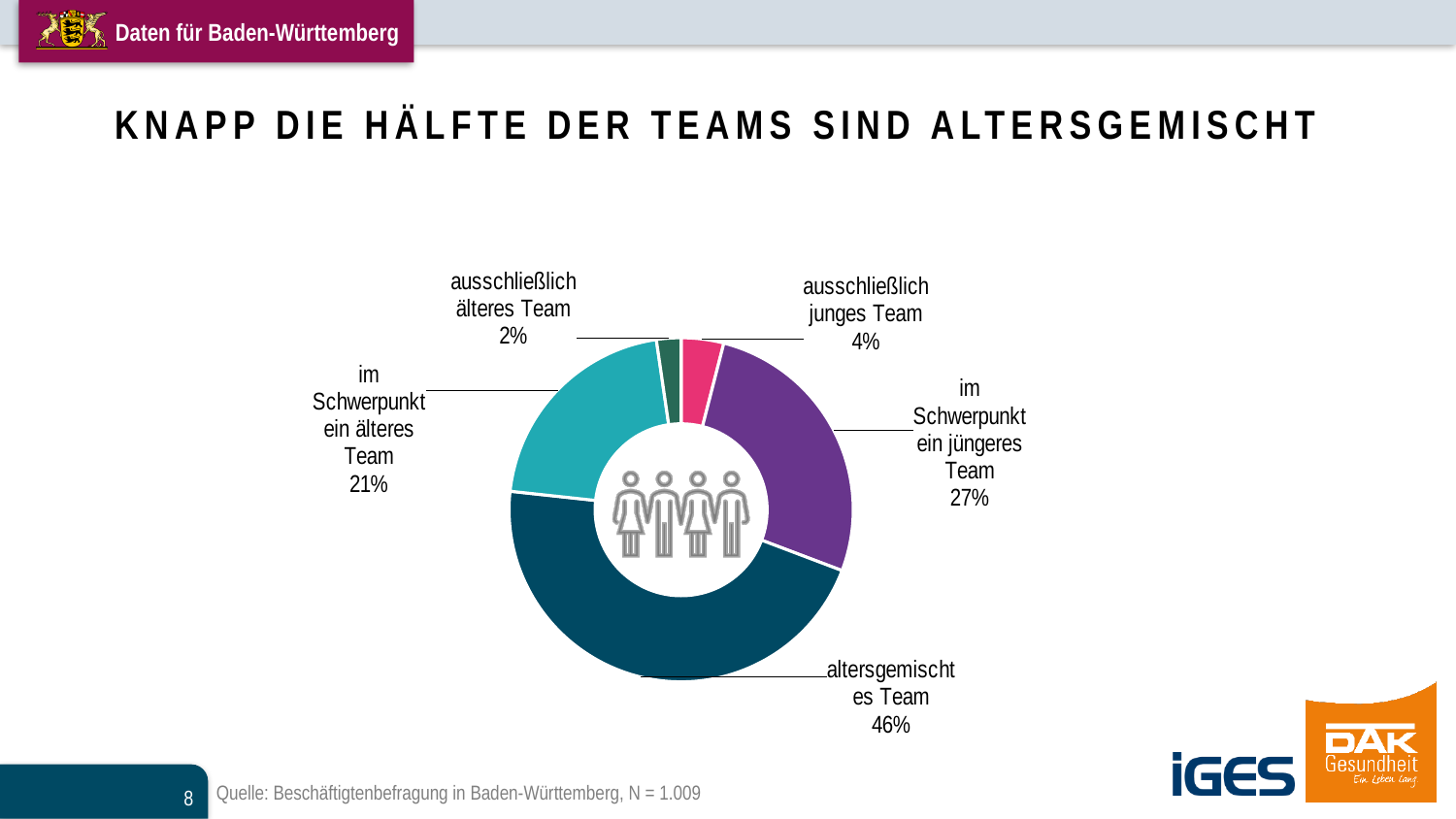
What kind of chart is shown on the slide? Pie chart (doughnut) How many categories are shown in the chart? 5 Which category has the smallest share of the chart? ausschließlich älteres Team What is the title of the slide? KNAPP DIE HÄLFTE DER TEAMS SIND ALTERSGEMISCHT What is the difference in percentage points between 'altersgemischtes Team' and 'im Schwerpunkt ein jüngeres Team'? 19 percentage points What share of teams is 'ausschließlich älteres Team'? 2% Which is larger: 'im Schwerpunkt ein jüngeres Team' or 'im Schwerpunkt ein älteres Team'? im Schwerpunkt ein jüngeres Team Which category has the largest share of the chart? altersgemischtes Team What share of teams is 'im Schwerpunkt ein älteres Team'? 21% What share of teams is 'ausschließlich junges Team'? 4% What share of teams is 'altersgemischtes Team'? 46% What share of teams is 'im Schwerpunkt ein jüngeres Team'? 27%